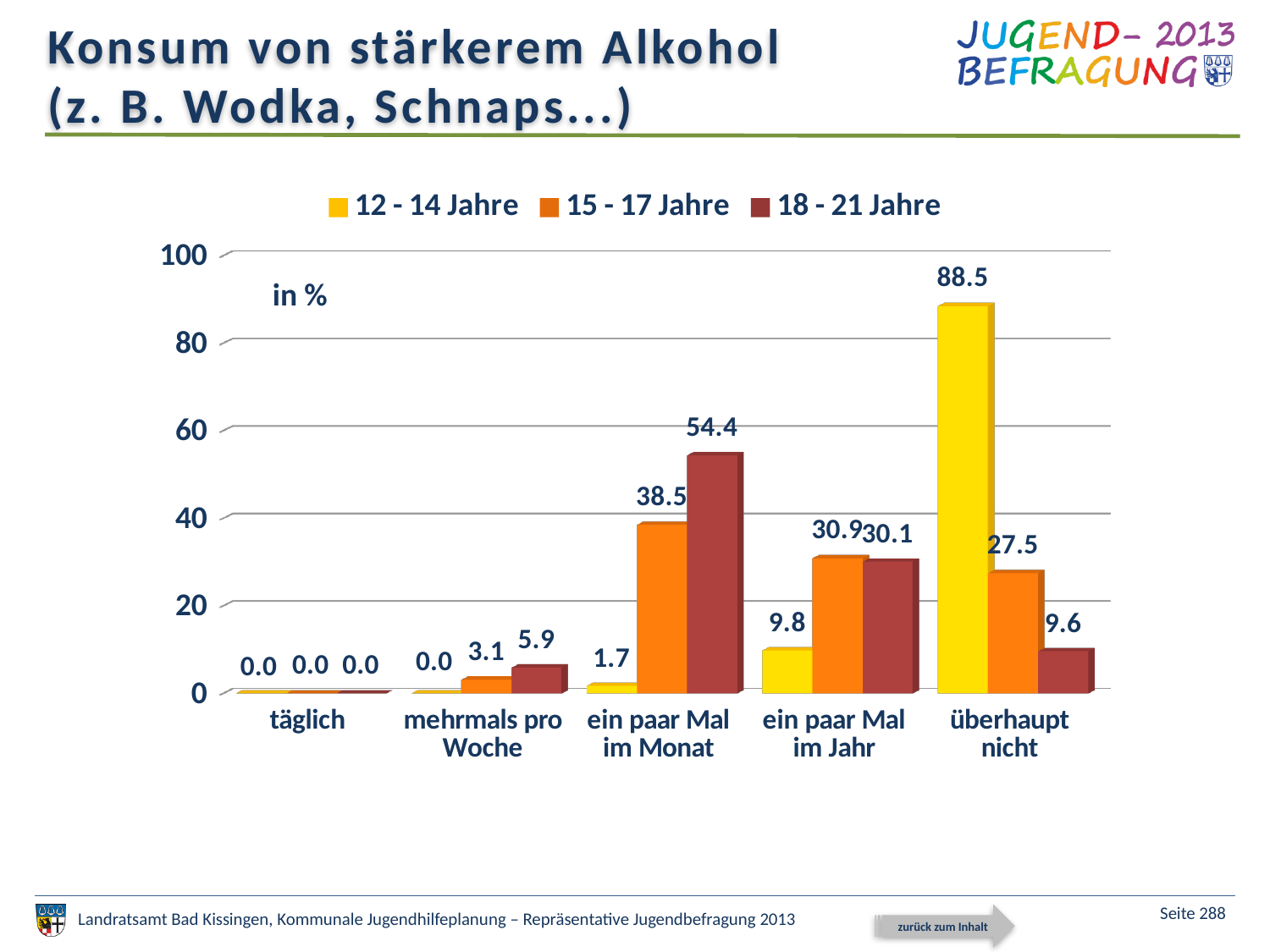
In which category does the 18 - 21 Jahre series have its lowest value? täglich What kind of chart is shown on the slide? bar chart What is the value for 18 - 21 Jahre in the category "ein paar Mal im Monat"? 54.4 What is the difference between the 18 - 21 Jahre and 15 - 17 Jahre values in the category "ein paar Mal im Monat"? 15.9 In which category does the 15 - 17 Jahre series reach its highest value? ein paar Mal im Monat What unit is indicated inside the chart area? in % What is the value for 12 - 14 Jahre in the category "ein paar Mal im Jahr"? 9.8 What is the value for 15 - 17 Jahre in the category "mehrmals pro Woche"? 3.1 In the category "überhaupt nicht", which series has the larger value: 15 - 17 Jahre or 18 - 21 Jahre? 15 - 17 Jahre What is the value for 12 - 14 Jahre in the category "überhaupt nicht"? 88.5 How many series does the legend list? 3 How many categories are shown on the x axis? 5